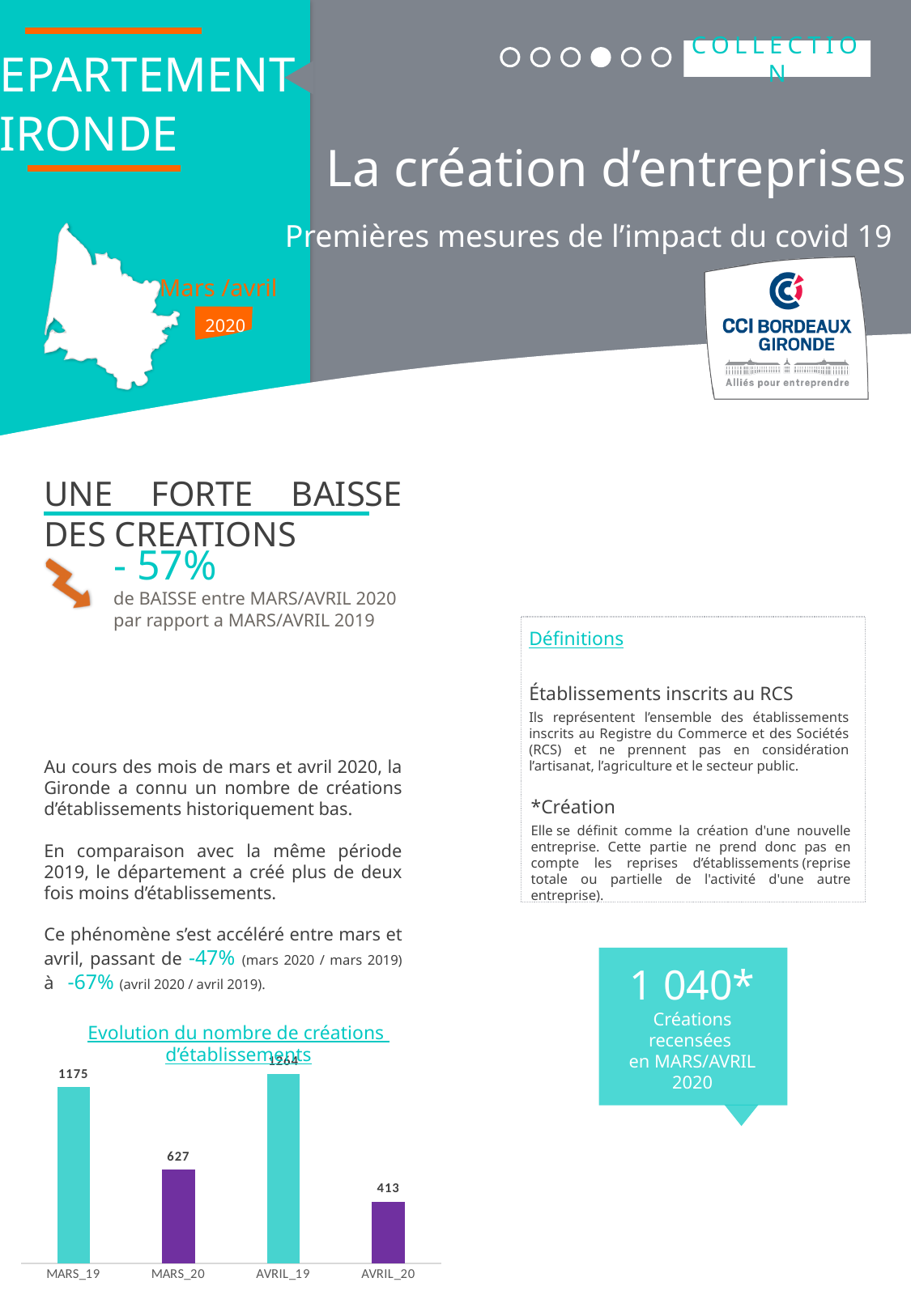
In the chart "Evolution du nombre de créations d'établissements", which category has the highest value? AVRIL_19 In the chart "Evolution du nombre de créations d'établissements", what is the value for AVRIL_20? 413 In the chart "Evolution du nombre de créations d'établissements", what is the value for MARS_20? 627 How many categories are shown on the x axis of the chart "Evolution du nombre de créations d'établissements"? 4 In the chart "Evolution du nombre de créations d'établissements", what is the difference between the values for MARS_20 and AVRIL_20? 214 What type of chart is shown under the title "Evolution du nombre de créations d'établissements"? bar chart In the chart "Evolution du nombre de créations d'établissements", what colour are the bars for the 2020 categories (MARS_20 and AVRIL_20)? purple In the chart "Evolution du nombre de créations d'établissements", which is larger, the value for MARS_19 or the value for AVRIL_19? AVRIL_19 In the chart "Evolution du nombre de créations d'établissements", what is the value for MARS_19? 1175 In the chart "Evolution du nombre de créations d'établissements", what is the difference between the values for MARS_19 and MARS_20? 548 In the chart "Evolution du nombre de créations d'établissements", which category has the lowest value? AVRIL_20 In the chart "Evolution du nombre de créations d'établissements", which is larger, the value for MARS_20 or the value for AVRIL_20? MARS_20